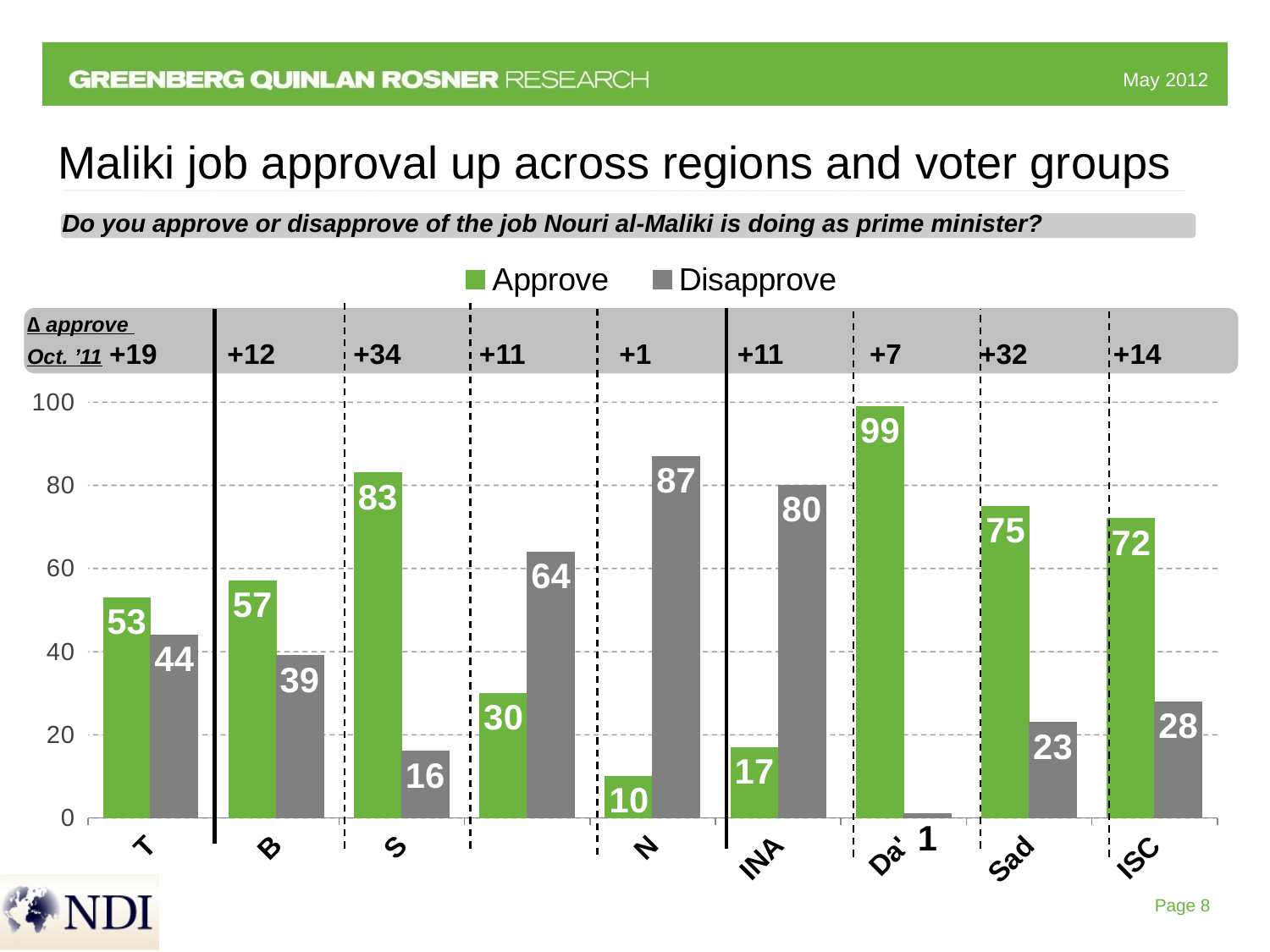
Which is larger for INA, the Approve value or the Disapprove value? Disapprove What is the Approve value for Da'? 99 How many series does the legend list? 2 What is the Disapprove value for ISC? 28 Which category has the highest Approve value? Da' What is the Approve value for S? 83 What is the difference between the Approve and Disapprove values for T? 9 What kind of chart is shown on the slide? Bar chart What is the Approve value for Sad? 75 Which category has the lowest Disapprove value? Da' What colour are the Approve bars? Green What is the Disapprove value for N? 87